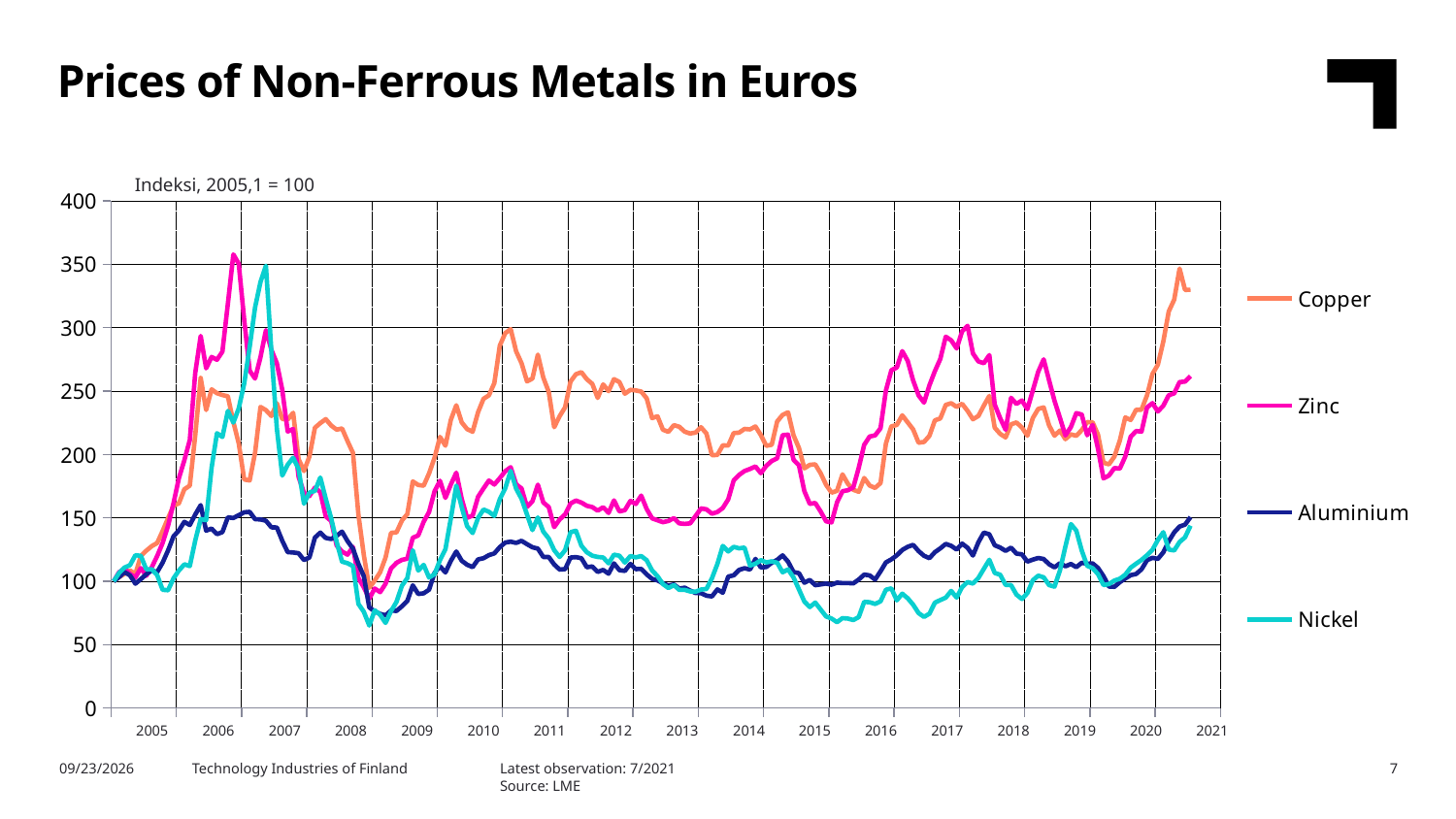
Which is larger in 2017, the value for Zinc or the value for Aluminium? Zinc Is the value for Aluminium in 2017 greater or less than 200? less Which series has the lowest value around 2015? Nickel Is the value for Copper at the end of the chart in 2021 greater or less than 300? greater How many series does the legend list? 4 Which series does the legend list between Zinc and Nickel? Aluminium Does the value for Copper rise or fall from 2019 to 2021? Rise What kind of chart is shown on the slide? Line chart What is the title of the chart? Prices of Non-Ferrous Metals in Euros Which series has the highest value at the end of the chart in 2021? Copper Is the peak value for Zinc in 2006 greater or less than 300? greater